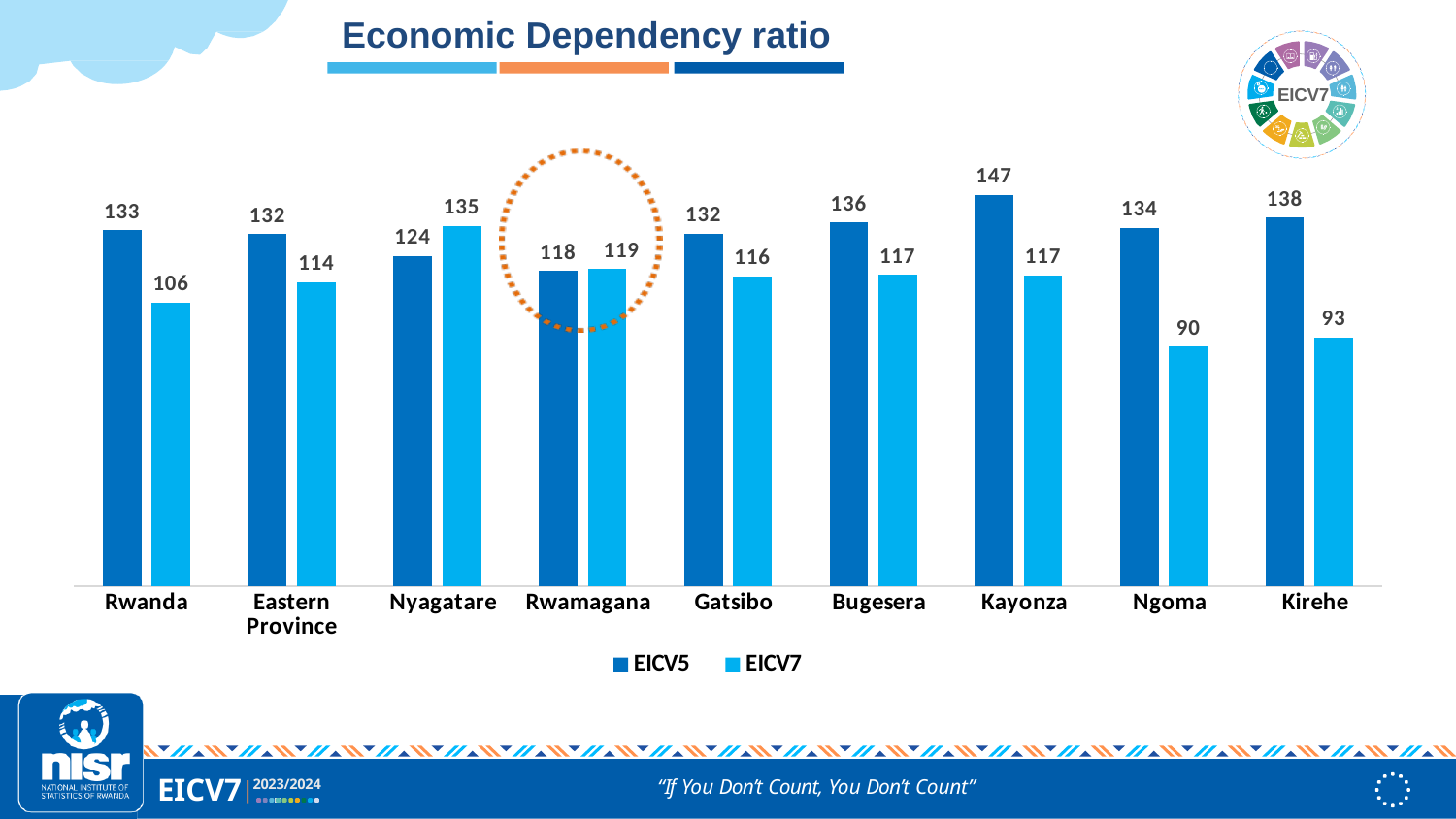
What is the EICV7 economic dependency ratio for Rwanda? 106 Which category has the lowest EICV7 value? Ngoma Which is larger for Nyagatare, the EICV5 value or the EICV7 value? EICV7 Which is larger for Bugesera, the EICV5 value or the EICV7 value? EICV5 What type of chart is shown on the slide? Bar chart Which category has the highest EICV5 value? Kayonza How many series does the legend list? 2 What is the difference between the EICV5 and EICV7 values for Rwanda? 27 How many categories are shown on the x axis? 9 What is the difference between the EICV5 and EICV7 values for Kirehe? 45 What is the EICV5 economic dependency ratio for Kayonza? 147 What is the EICV7 value for Nyagatare? 135